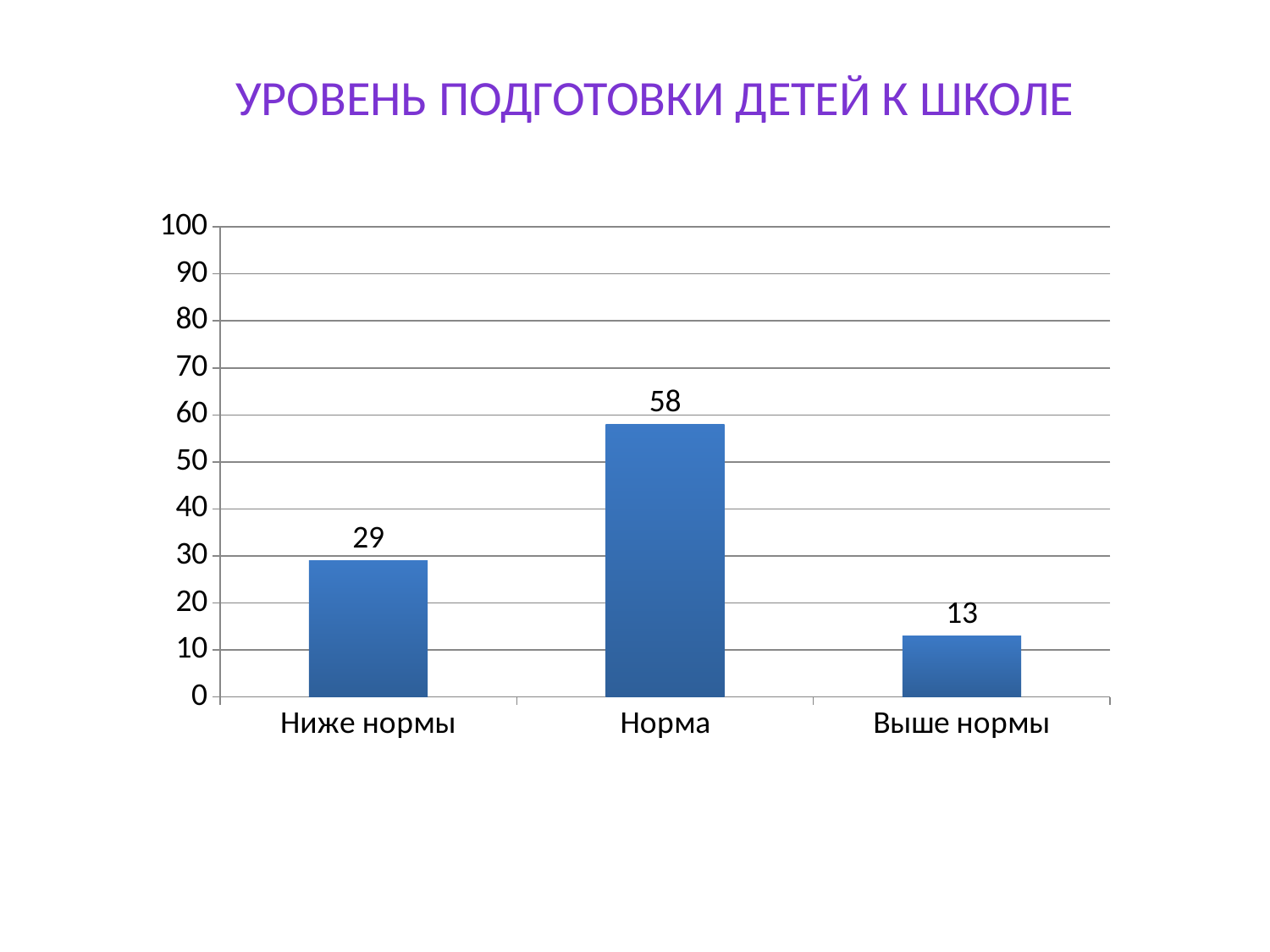
What is the difference between the values for Норма and Ниже нормы? 29 Which category has the lowest value? Выше нормы What is the difference between the values for Ниже нормы and Выше нормы? 16 Which is larger, the value for Ниже нормы or the value for Выше нормы? Ниже нормы What kind of chart is shown on the slide? bar chart Which category has the highest value? Норма What is the value for Ниже нормы? 29 What is the title of the slide? УРОВЕНЬ ПОДГОТОВКИ ДЕТЕЙ К ШКОЛЕ What is the value for Выше нормы? 13 What is the value for Норма? 58 Is the value for Норма greater or less than 50? greater How many categories are shown on the x axis? 3